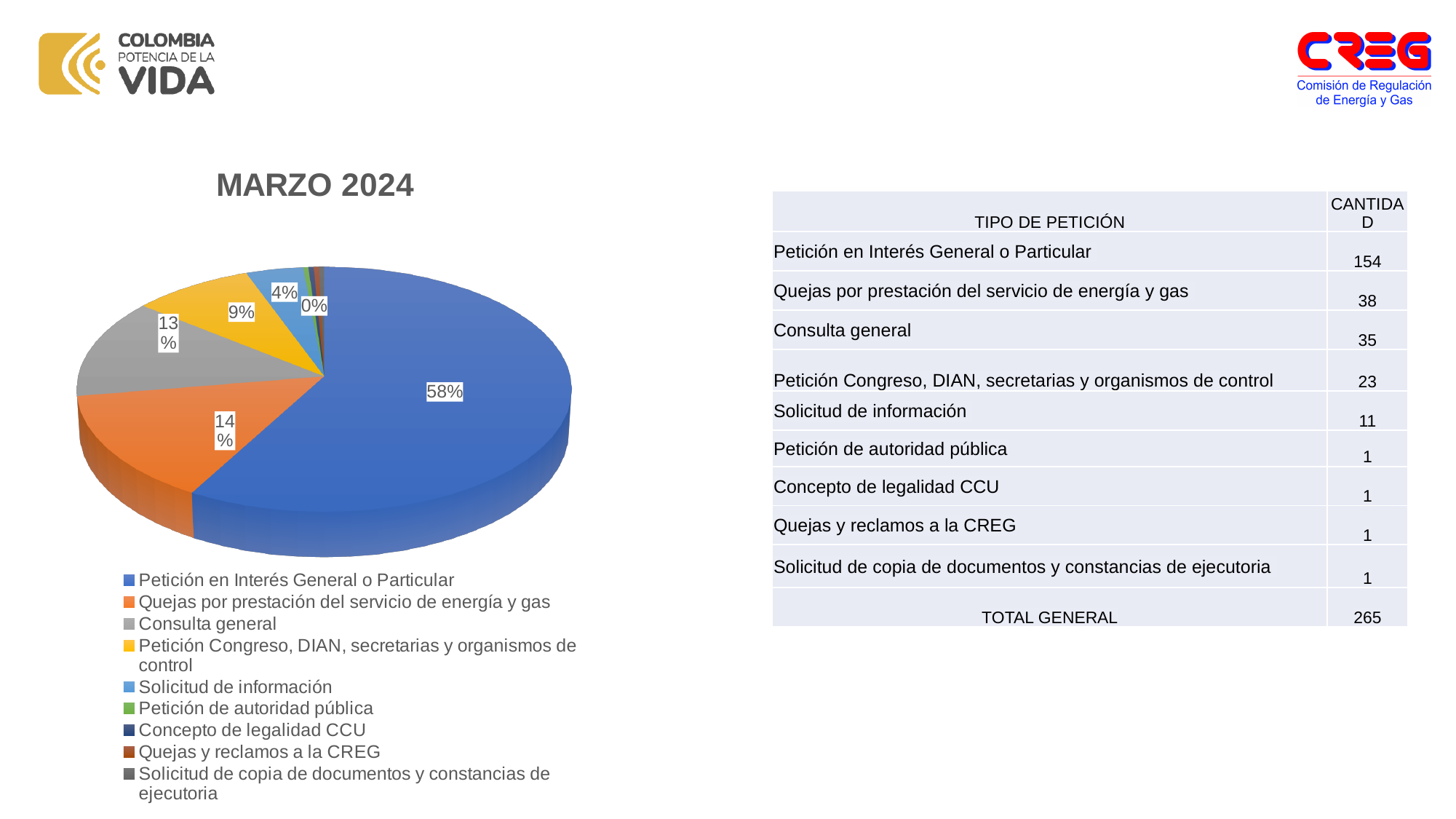
What kind of chart is shown on the slide? Pie chart How many categories are listed in the pie chart's legend? 9 What share of the pie does 'Solicitud de información' represent? 4% What share of the pie does 'Quejas por prestación del servicio de energía y gas' represent? 14% Which slice is larger: 'Quejas por prestación del servicio de energía y gas' or 'Consulta general'? Quejas por prestación del servicio de energía y gas What share of the pie does 'Petición en Interés General o Particular' represent? 58% What is the title of the pie chart? MARZO 2024 What colour is the largest slice of the pie chart? Blue Which category has the largest slice of the pie? Petición en Interés General o Particular What is the difference in percentage points between the 'Petición en Interés General o Particular' slice and the 'Quejas por prestación del servicio de energía y gas' slice? 44 percentage points